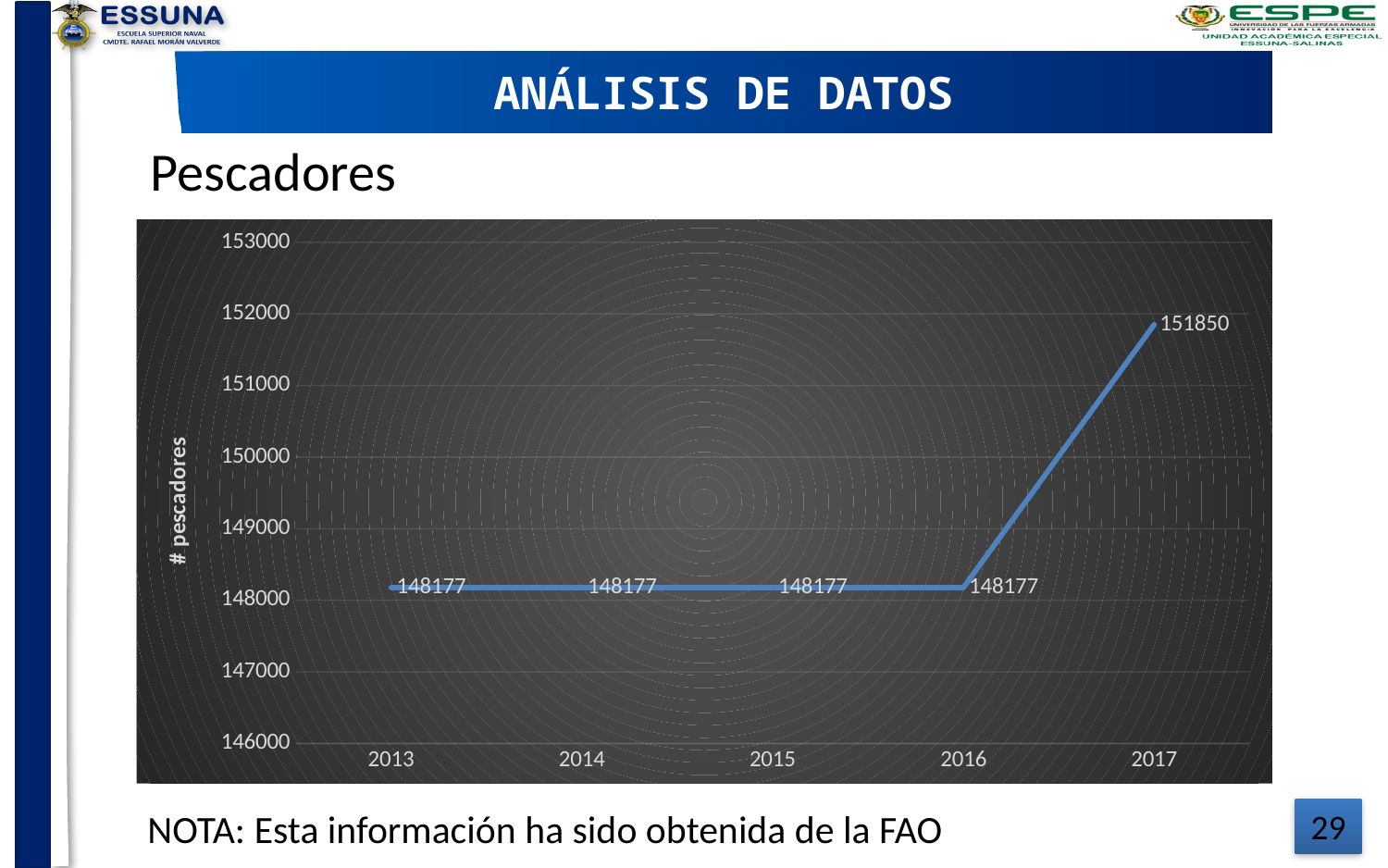
How many years are plotted on the x axis? 5 What is the number of pescadores in 2013? 148177 Is the number of pescadores in 2014 greater or less than 149000? less What is the number of pescadores in 2017? 151850 What kind of chart is shown on the slide? line chart What is the difference in the number of pescadores between 2017 and 2016? 3673 What is the label of the vertical axis? # pescadores What is the number of pescadores in 2015? 148177 Is the number of pescadores in 2017 greater or less than 151000? greater Which is larger, the value for 2016 or the value for 2017? 2017 Does the number of pescadores rise or fall from 2016 to 2017? rise Which year has the highest number of pescadores? 2017